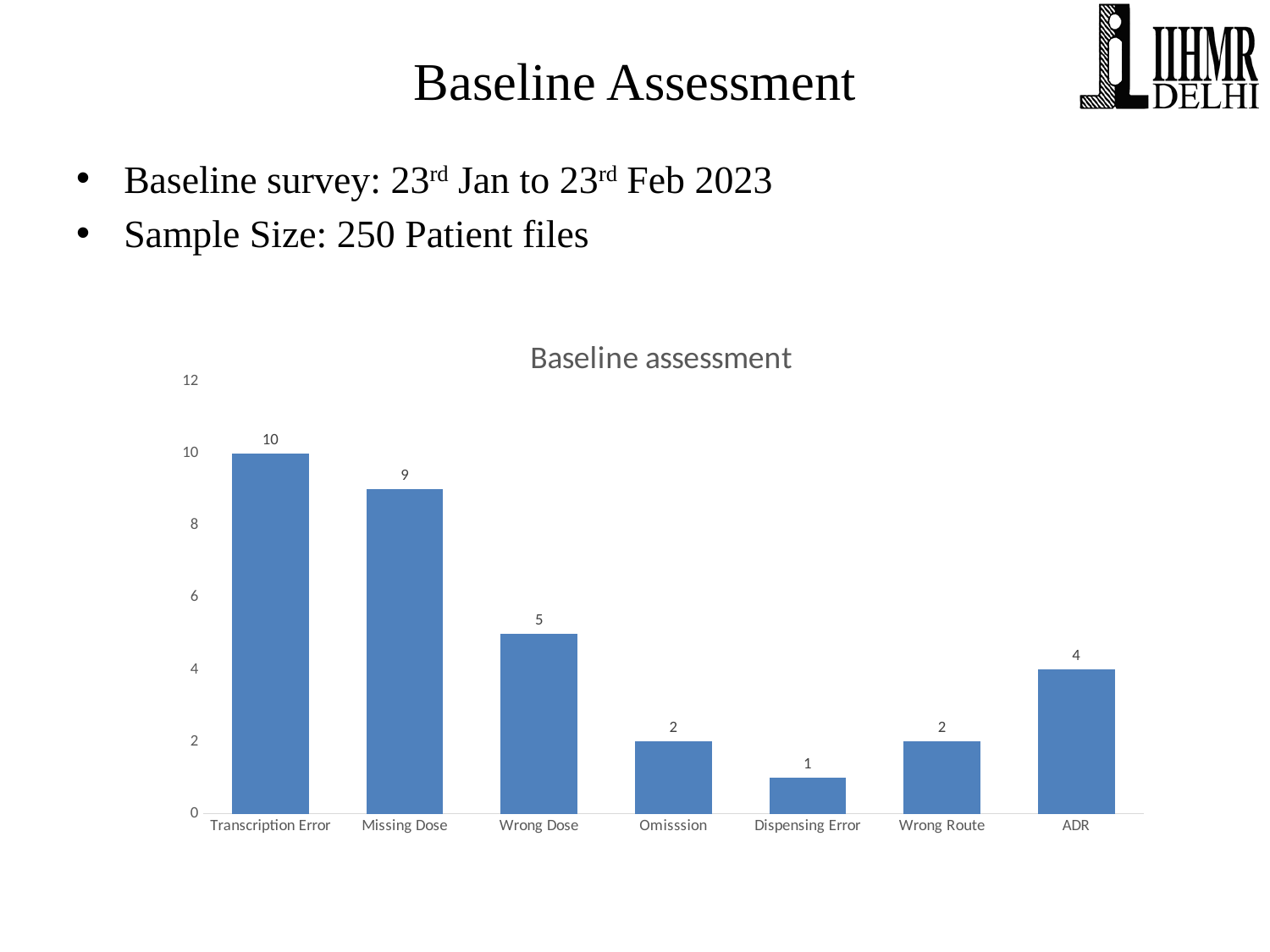
Is the value for Missing Dose greater or less than 8? greater What is the difference between the values for Transcription Error and Missing Dose? 1 Which category has the lowest value? Dispensing Error What is the title of the chart? Baseline assessment What is the value for Wrong Dose? 5 Which is larger, the value for Missing Dose or the value for ADR? Missing Dose What kind of chart is shown on the slide? Bar chart What is the value for ADR? 4 How many categories are shown on the x axis? 7 Which category has the highest value? Transcription Error What is the value for Transcription Error? 10 What is the difference between the values for Wrong Dose and Omisssion? 3